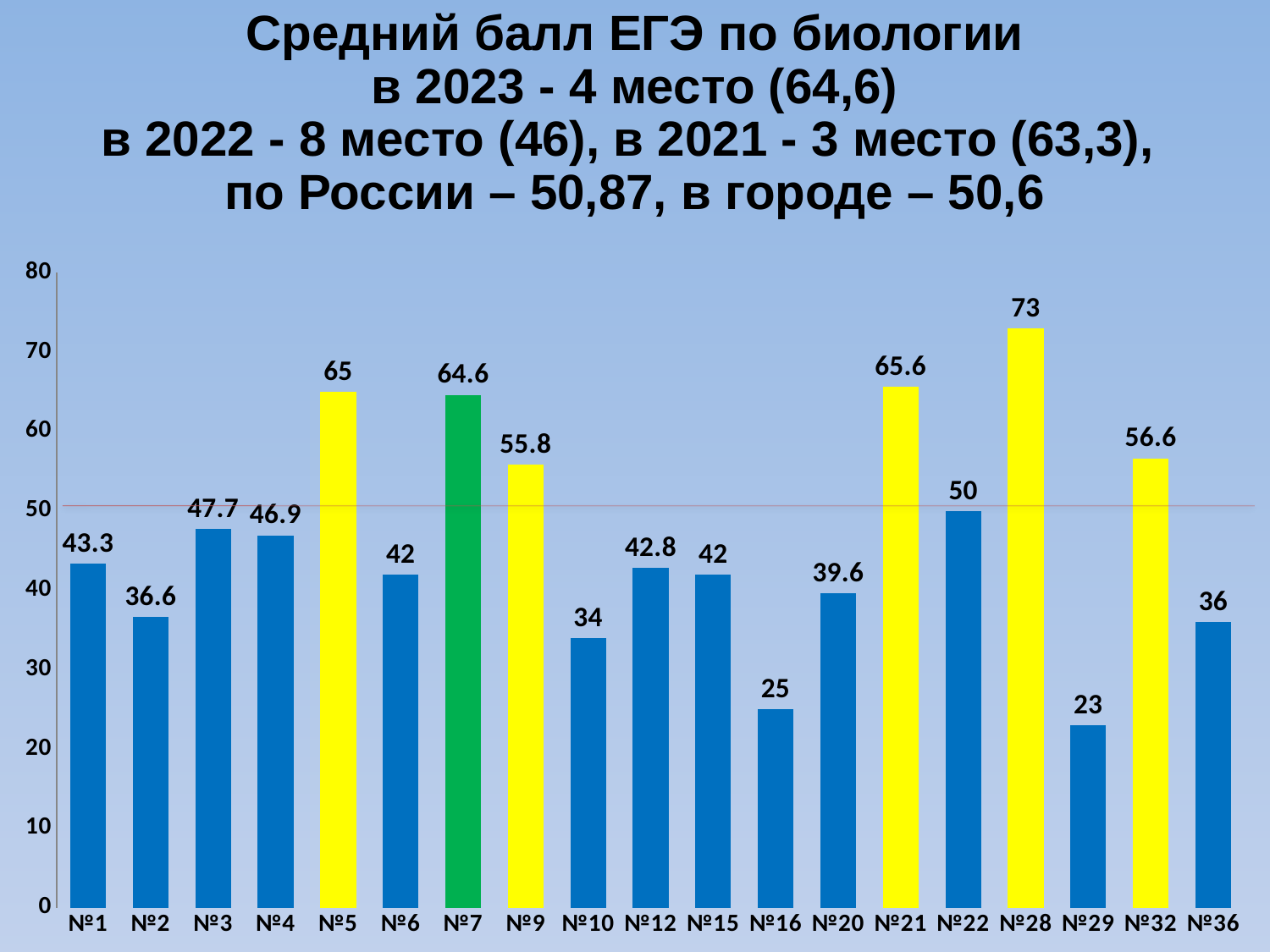
Is the value for №9 greater or less than 50? greater Which category has the highest value? №28 What is the value shown for №16? 25 Which category has the lowest value? №29 What is the difference between the values for №32 and №36? 20.6 What is the value shown for №7? 64.6 What kind of chart is shown on the slide? bar chart Which is larger, the value for №3 or the value for №10? №3 What is the difference between the values for №28 and №29? 50 Which category is shown with a green bar? №7 What is the value shown for №21? 65.6 How many categories are shown on the x axis? 19